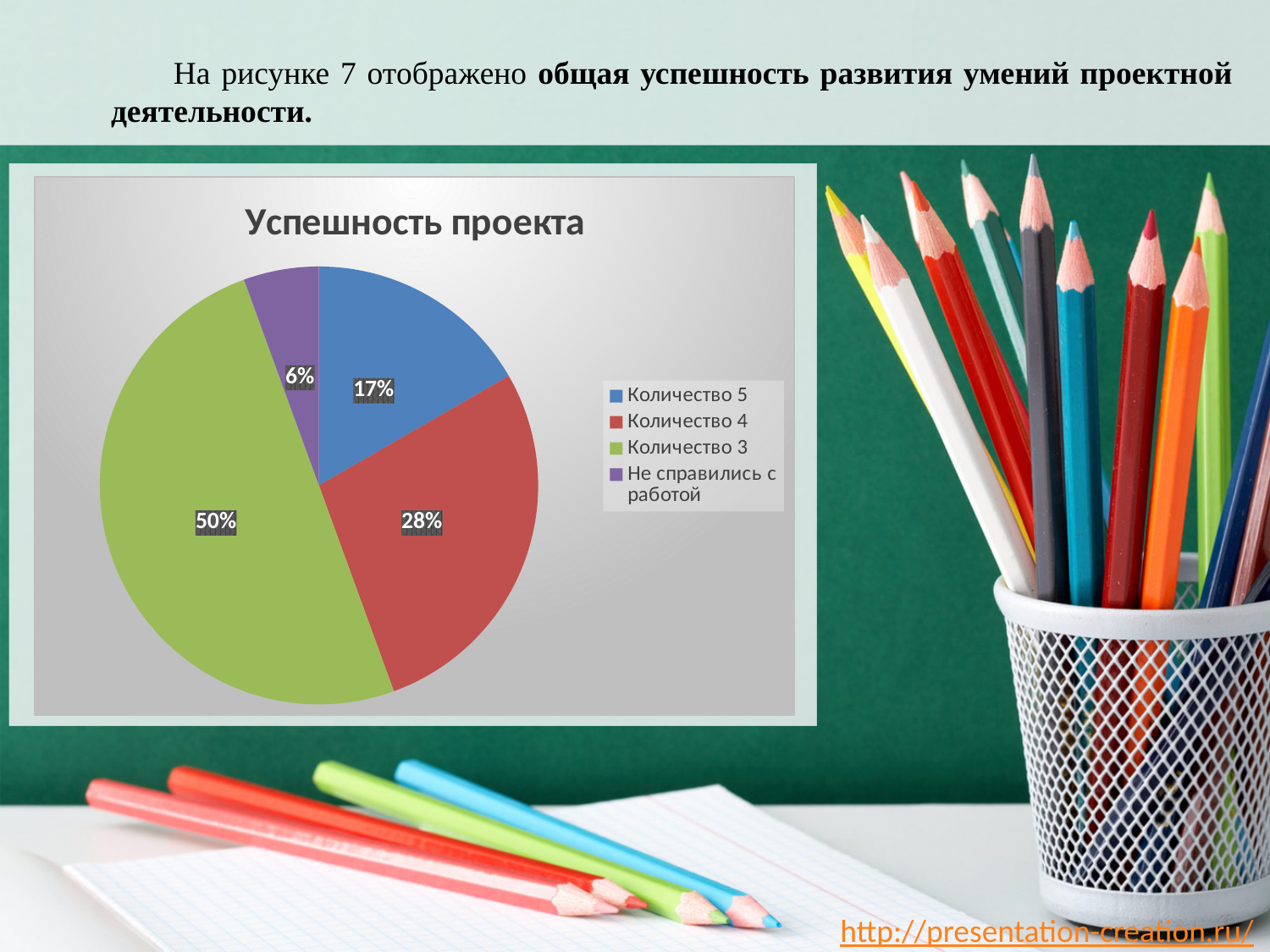
What share of the pie does "Количество 3" take? 50% What is the value shown for "Не справились с работой"? 6% Which is larger, the share for "Количество 5" or for "Количество 4"? Количество 4 Which category has the smallest slice of the pie? Не справились с работой Which category has the largest slice of the pie? Количество 3 What kind of chart is shown on the slide? pie chart What is the title of the chart? Успешность проекта How many slices does the pie chart have? 4 What is the difference between the shares of "Количество 3" and "Количество 4"? 22% What colour is the slice for "Количество 3"? green What is the value shown for "Количество 5"? 17% What is the value shown for "Количество 4"? 28%